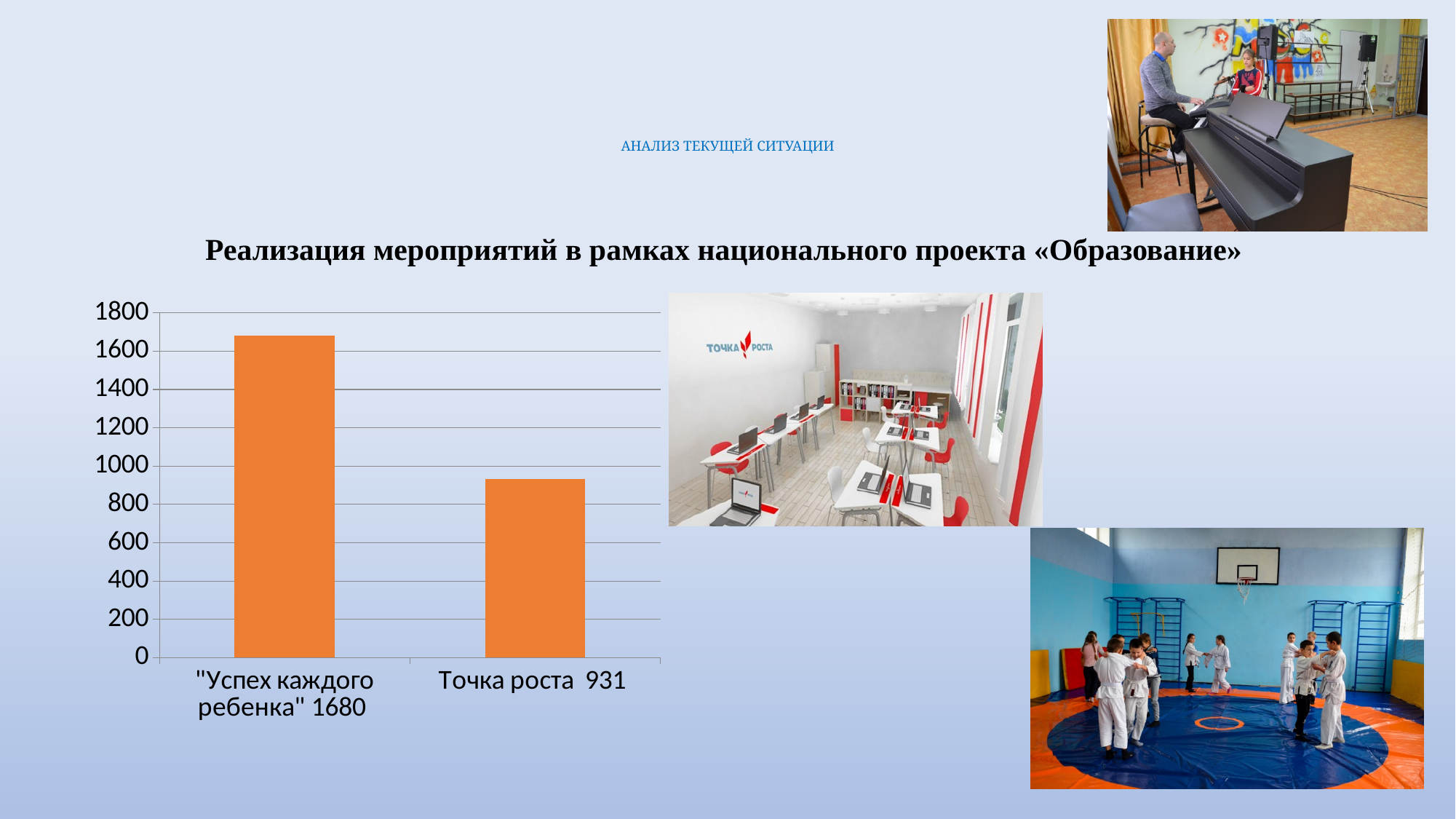
How many categories are shown in the chart? 2 Which is larger, the value for "Успех каждого ребенка" or for "Точка роста"? "Успех каждого ребенка" What colour are the bars in the chart? orange Is the value for "Успех каждого ребенка" greater or less than 1600? greater Which category has the lowest bar? Точка роста Which category has the highest bar? "Успех каждого ребенка" What value is shown for "Точка роста"? 931 What kind of chart is shown on the slide? bar chart Is the value for "Точка роста" greater or less than 1000? less What is the difference between the values for "Успех каждого ребенка" and "Точка роста"? 749 What value is shown for "Успех каждого ребенка"? 1680 What is the maximum value shown on the vertical axis of the chart? 1800